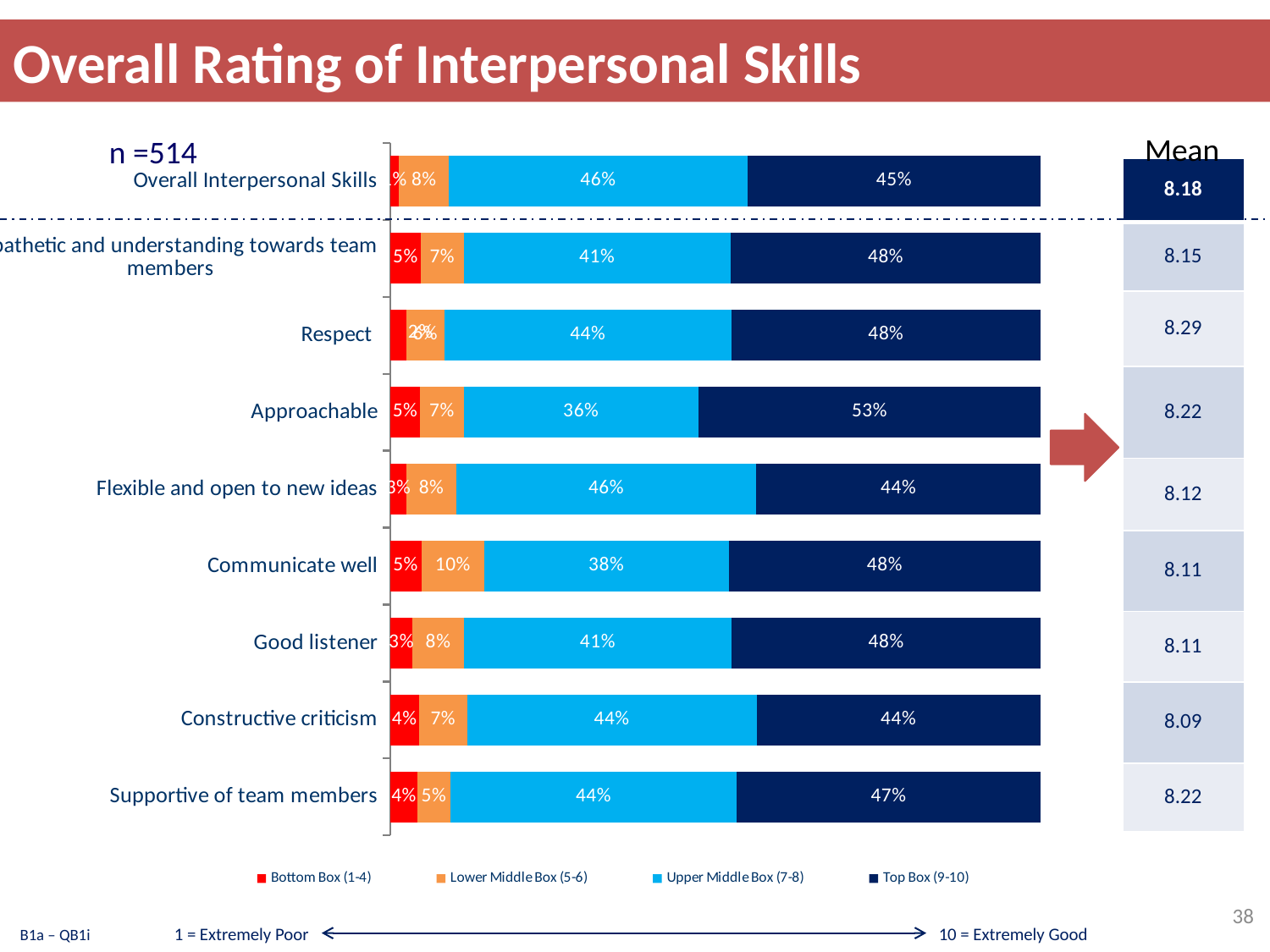
How many series does the legend list? 4 What is the Lower Middle Box (5-6) value for Communicate well? 10% What kind of chart is shown on the slide? Stacked bar chart What is the Top Box (9-10) value for Approachable? 53% What is the Mean shown for Respect? 8.29 What is the Top Box (9-10) value for Constructive criticism? 44% Which category has the highest Top Box (9-10) percentage? Approachable What is the difference between the Top Box (9-10) values for Approachable and Supportive of team members? 6 percentage points How many categories are plotted in the chart? 9 Which has a larger Upper Middle Box (7-8) value: Flexible and open to new ideas or Constructive criticism? Flexible and open to new ideas Which category has the lowest Upper Middle Box (7-8) percentage? Approachable What is the Upper Middle Box (7-8) value for Communicate well? 38%